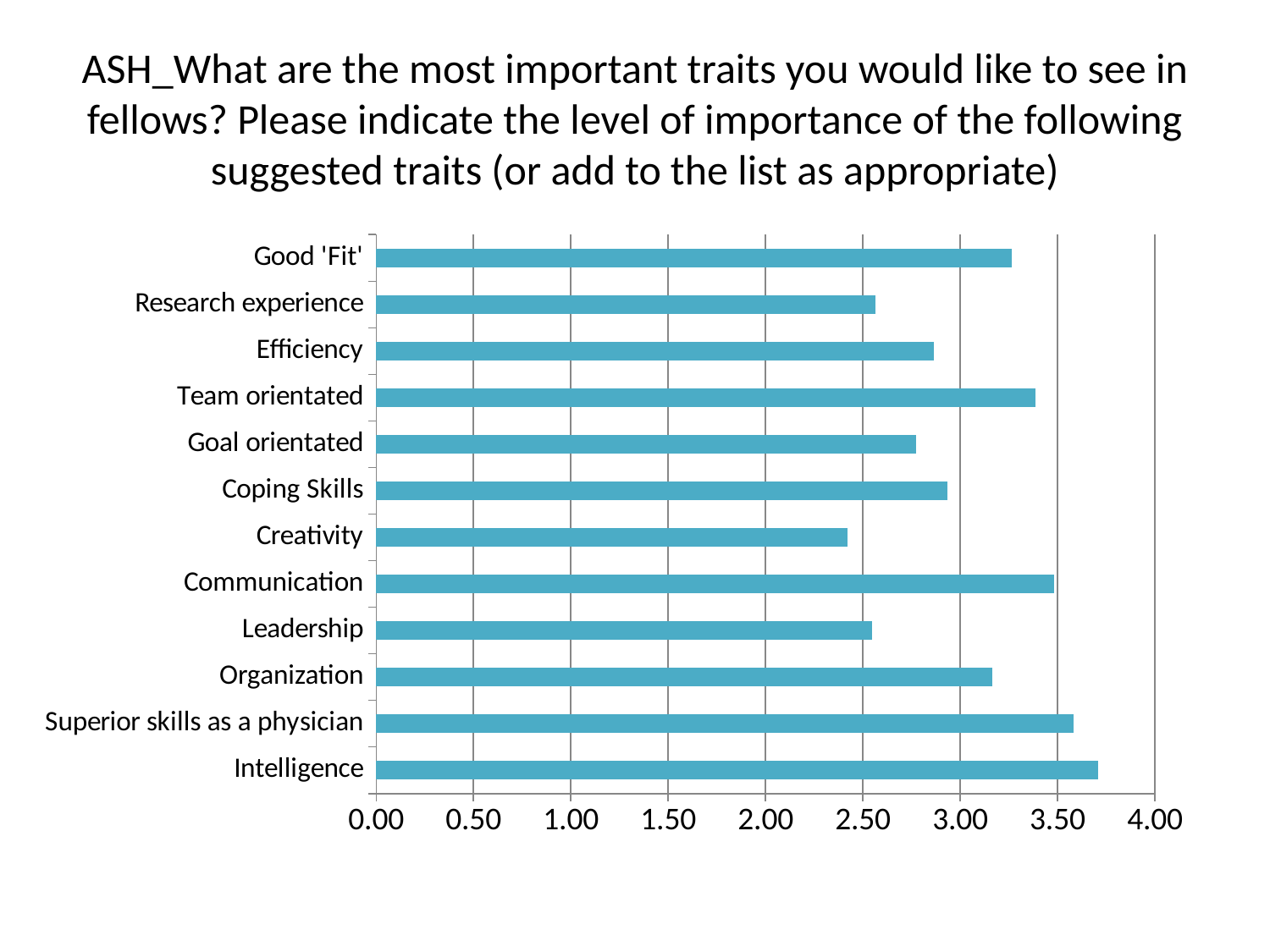
Is the value for Efficiency greater or less than 3.00? less Is the value for Superior skills as a physician greater or less than 3.50? greater What kind of chart is shown on the slide? bar chart Which trait has the lowest importance rating? Creativity Which has a higher value, Communication or Organization? Communication Is the value for Good 'Fit' greater or less than 3.00? greater Which has a higher value, Team orientated or Good 'Fit'? Team orientated How many traits are listed on the chart? 12 Which trait has the highest importance rating? Intelligence What is the maximum value shown on the horizontal axis? 4.00